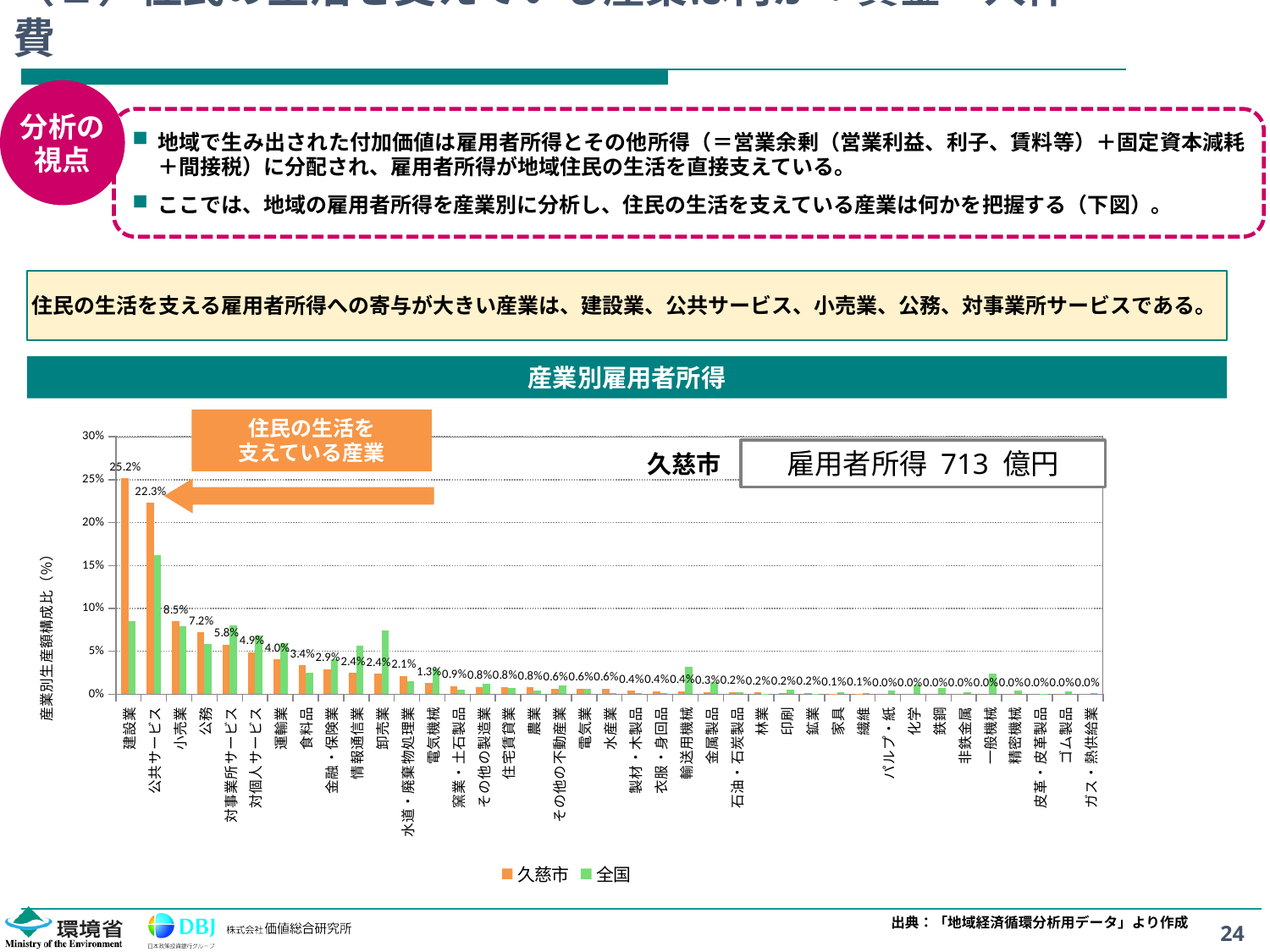
What is the value for 久慈市 in the 公務 category? 7.2% How many series does the legend list? 2 What kind of chart is shown on the slide? bar chart Which category has the highest value for 久慈市? 建設業 For 卸売業, which series has the larger value, 久慈市 or 全国? 全国 What is the difference between the 久慈市 values for 建設業 and 公共サービス? 2.9% Is the 全国 value for 建設業 greater or less than 10%? less What is the value for 久慈市 in the 小売業 category? 8.5% What is the value for 久慈市 in the 公共サービス category? 22.3% What is the title of the chart? 産業別雇用者所得 For 建設業, which series has the larger value, 久慈市 or 全国? 久慈市 What is the value for 久慈市 in the 建設業 category? 25.2%